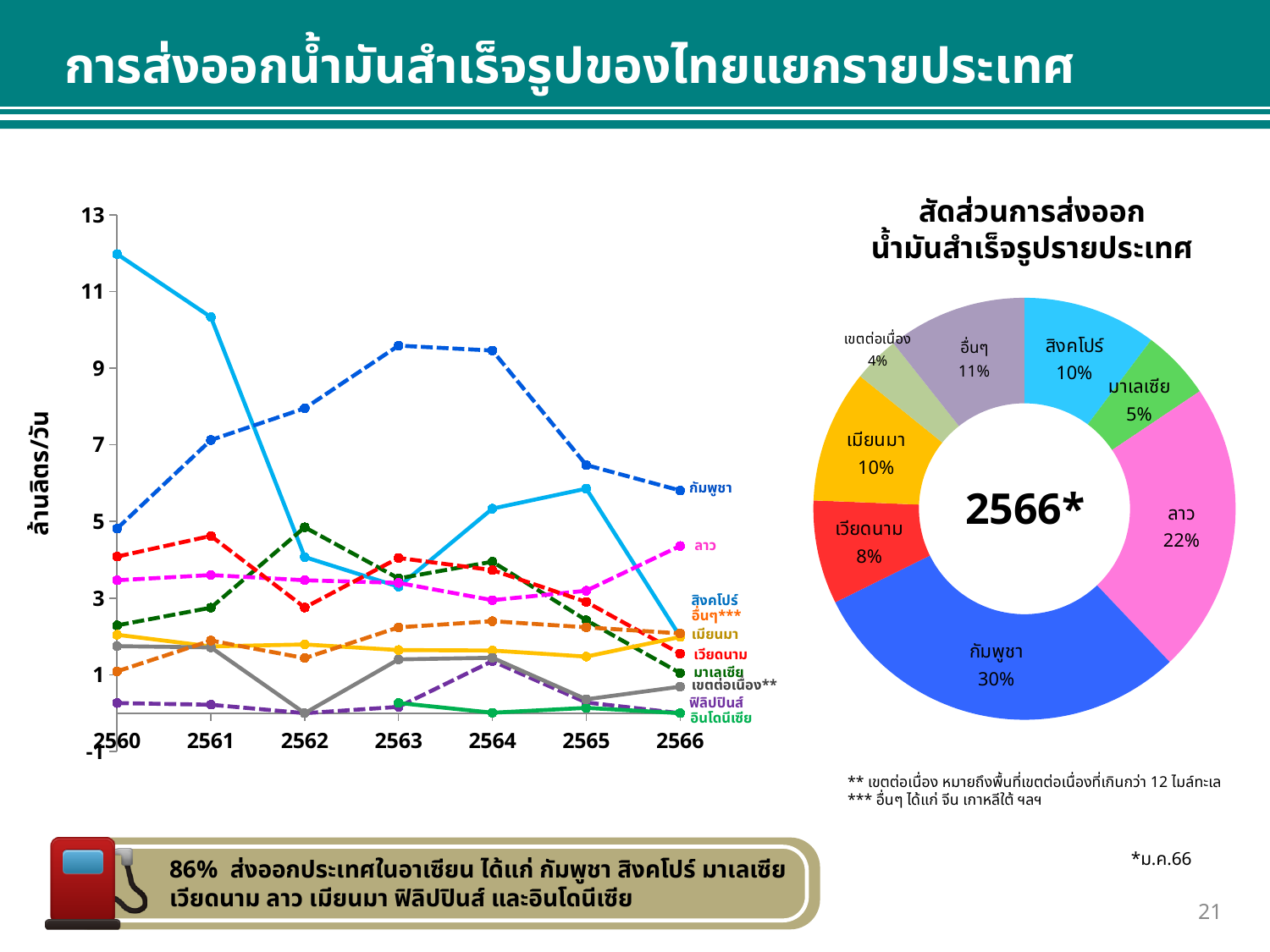
In the line chart on the left, does the value for กัมพูชา rise or fall from 2563 to 2566? fall In the donut chart on the right, what share does ลาว have? 22% In the donut chart on the right, what is the difference between the shares of กัมพูชา and ลาว? 8% In the donut chart on the right, which country has the largest share? กัมพูชา In the donut chart on the right, which category has the smallest share? เขตต่อเนื่อง What year is shown in the centre of the donut chart on the right? 2566* What kind of chart is the chart on the left of the slide? Line chart In the donut chart on the right, what share does กัมพูชา have? 30% In the donut chart on the right, which is larger, the share of สิงคโปร์ or the share of มาเลเซีย? สิงคโปร์ In the line chart on the left, how many years are shown on the x axis? 7 In the line chart on the left, is the value for สิงคโปร์ in 2560 greater or less than 11? greater How many slices does the donut chart on the right have? 8